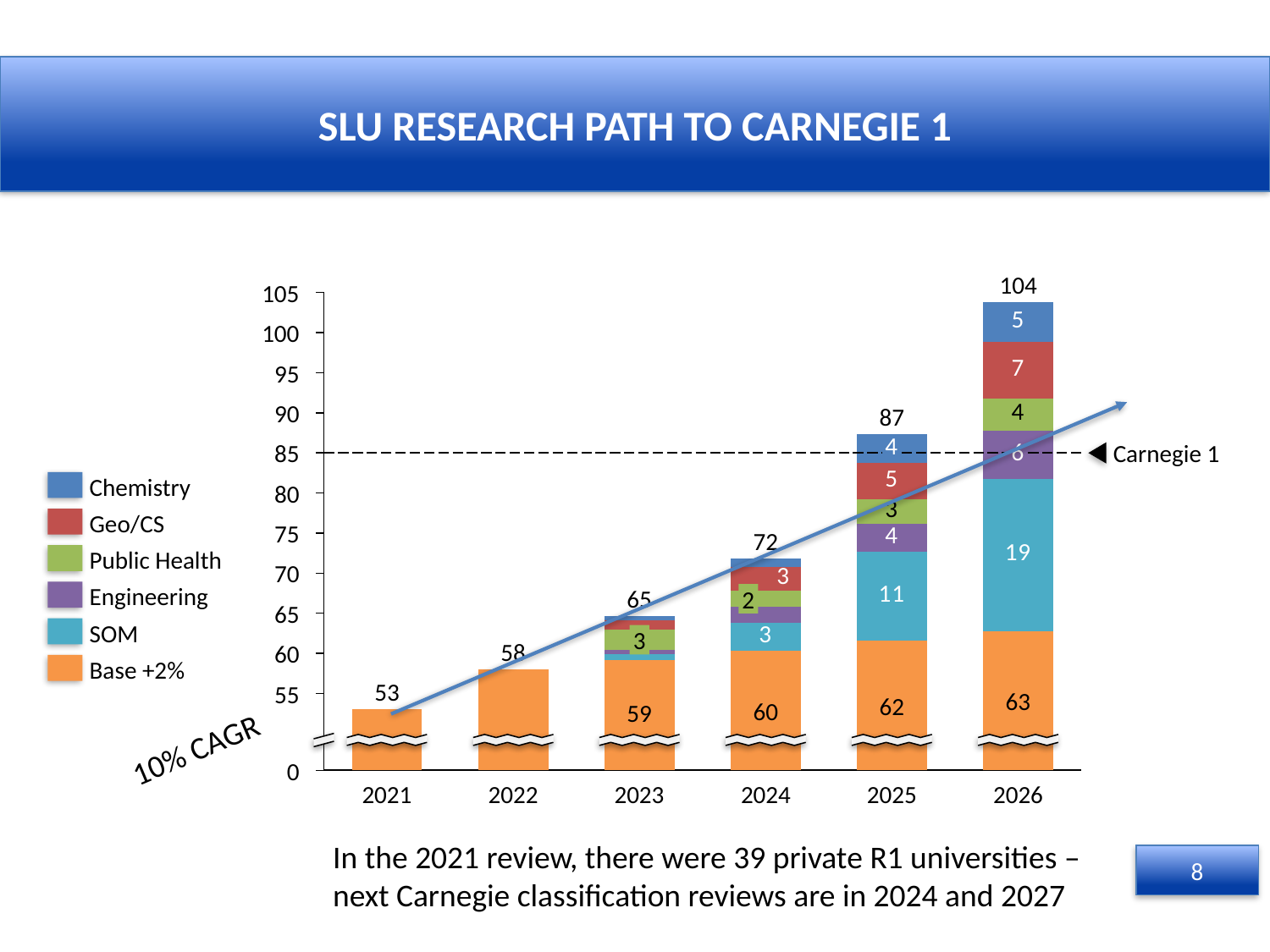
How many series does the legend list? 6 Is the SOM value larger in 2025 or in 2026? 2026 At what value is the dashed Carnegie 1 line drawn? 85 Which year has the highest total? 2026 What is the total value shown for the 2026 bar? 104 What is the Base +2% value in 2025? 62 What is the total value shown for the 2021 bar? 53 What is the SOM value in 2026? 19 What is the difference between the 2026 total and the 2025 total? 17 Which year has the lowest total? 2021 What is the Geo/CS value in 2026? 7 How many years are shown on the x axis? 6